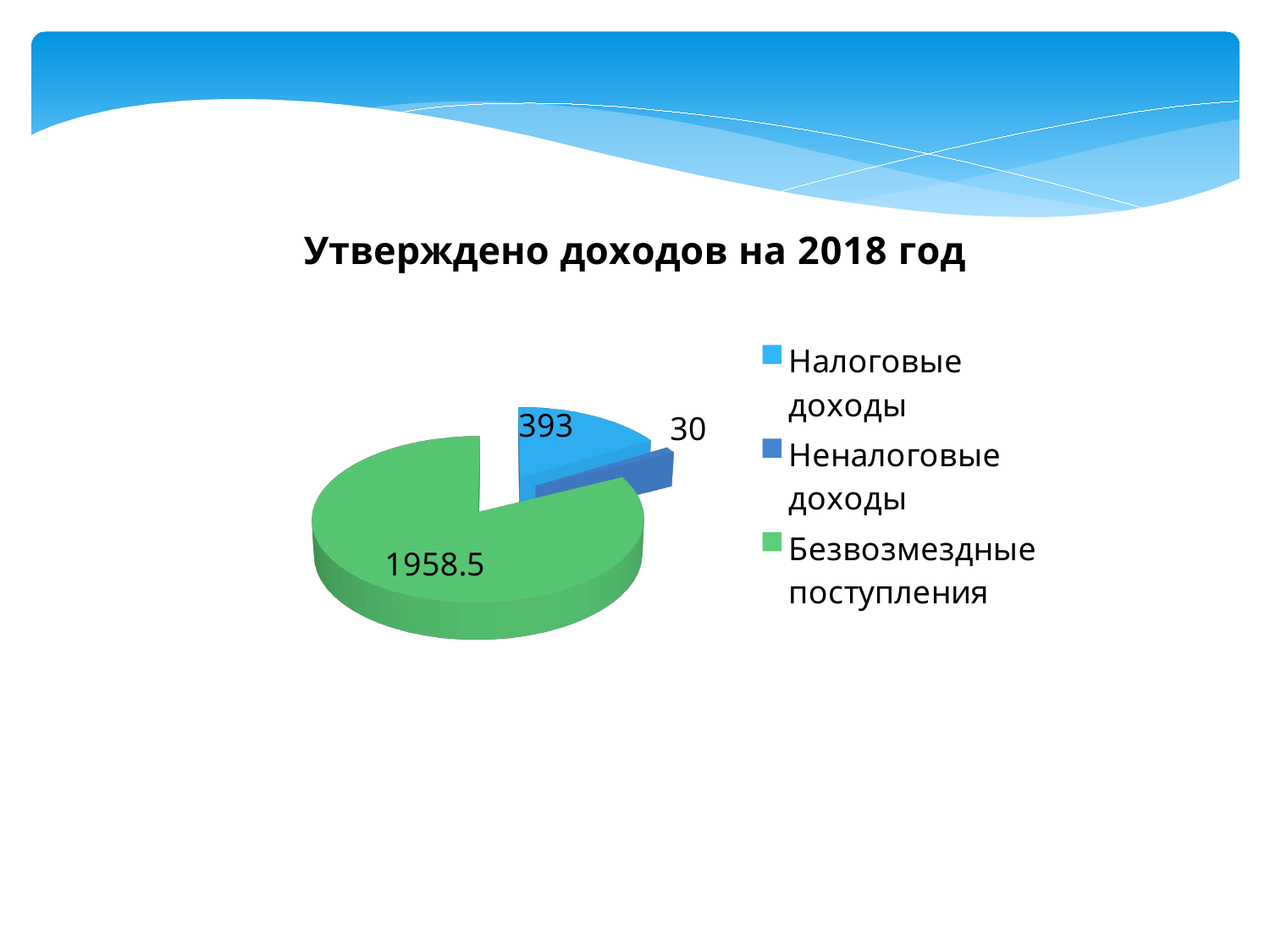
What is the value for Налоговые доходы? 393 What type of chart is shown on the slide? Pie chart Which category has the largest slice of the pie? Безвозмездные поступления What is the value for Безвозмездные поступления? 1958.5 Which is larger, Налоговые доходы or Неналоговые доходы? Налоговые доходы Which category has the smallest slice of the pie? Неналоговые доходы What is the total of all slices in the pie chart? 2381.5 What is the title of the chart? Утверждено доходов на 2018 год What is the difference between Налоговые доходы and Неналоговые доходы? 363 What is the difference between Безвозмездные поступления and Налоговые доходы? 1565.5 How many categories does the pie chart have? 3 What is the value for Неналоговые доходы? 30